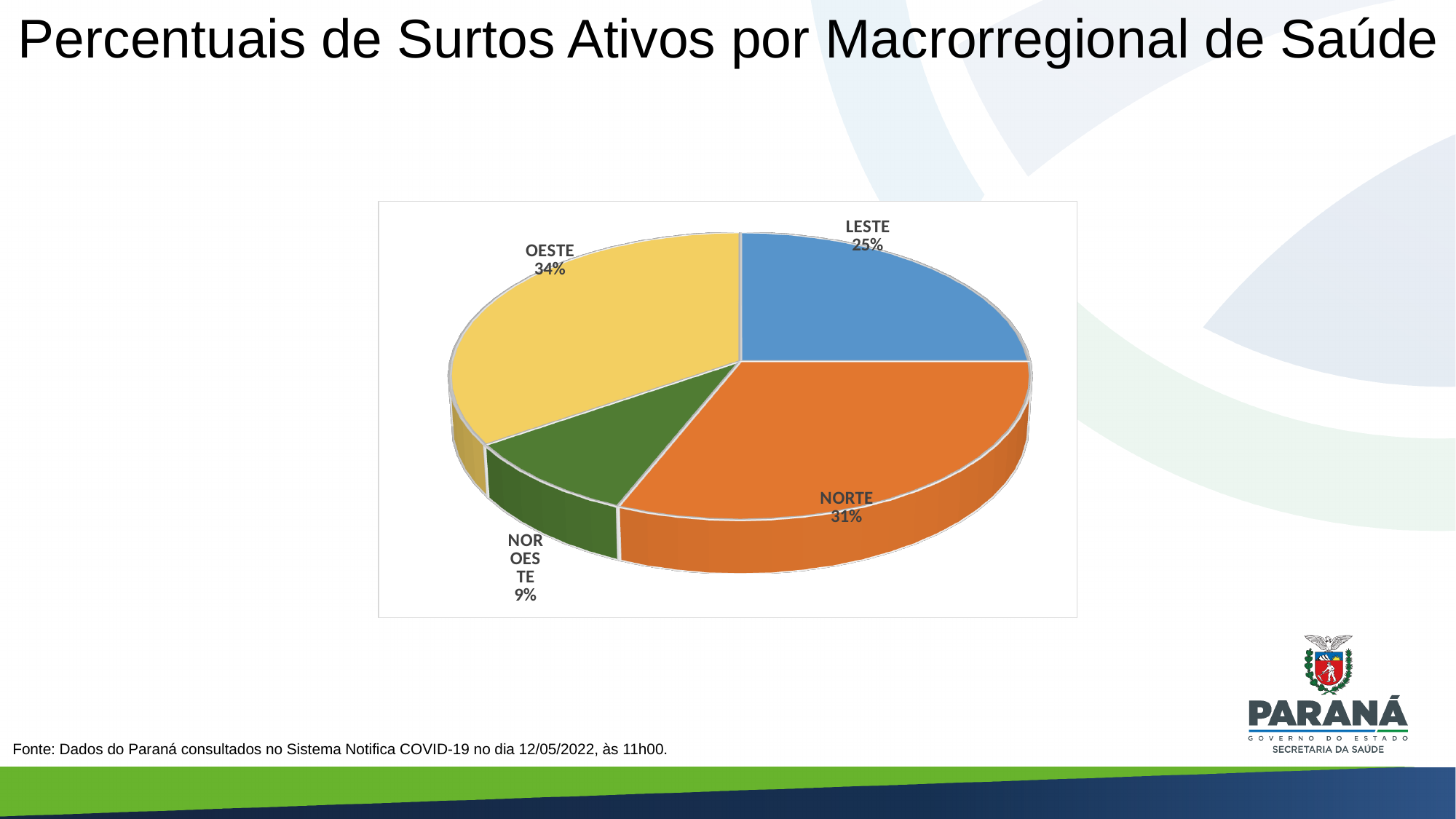
What colour is the NORTE slice? Orange What percentage is shown for the NOROESTE slice? 9% Which macroregion has the smallest share of active outbreaks? NOROESTE What percentage is shown for the NORTE slice? 31% What percentage is shown for the OESTE slice? 34% How many macroregions are shown in the pie chart? 4 What type of chart is shown on the slide? Pie chart Which macroregion has the largest share of active outbreaks? OESTE What percentage of active outbreaks does the LESTE macroregion account for? 25% What is the difference in percentage points between OESTE and NOROESTE? 25 Which has a larger share, LESTE or NORTE? NORTE What is the difference in percentage points between NORTE and LESTE? 6